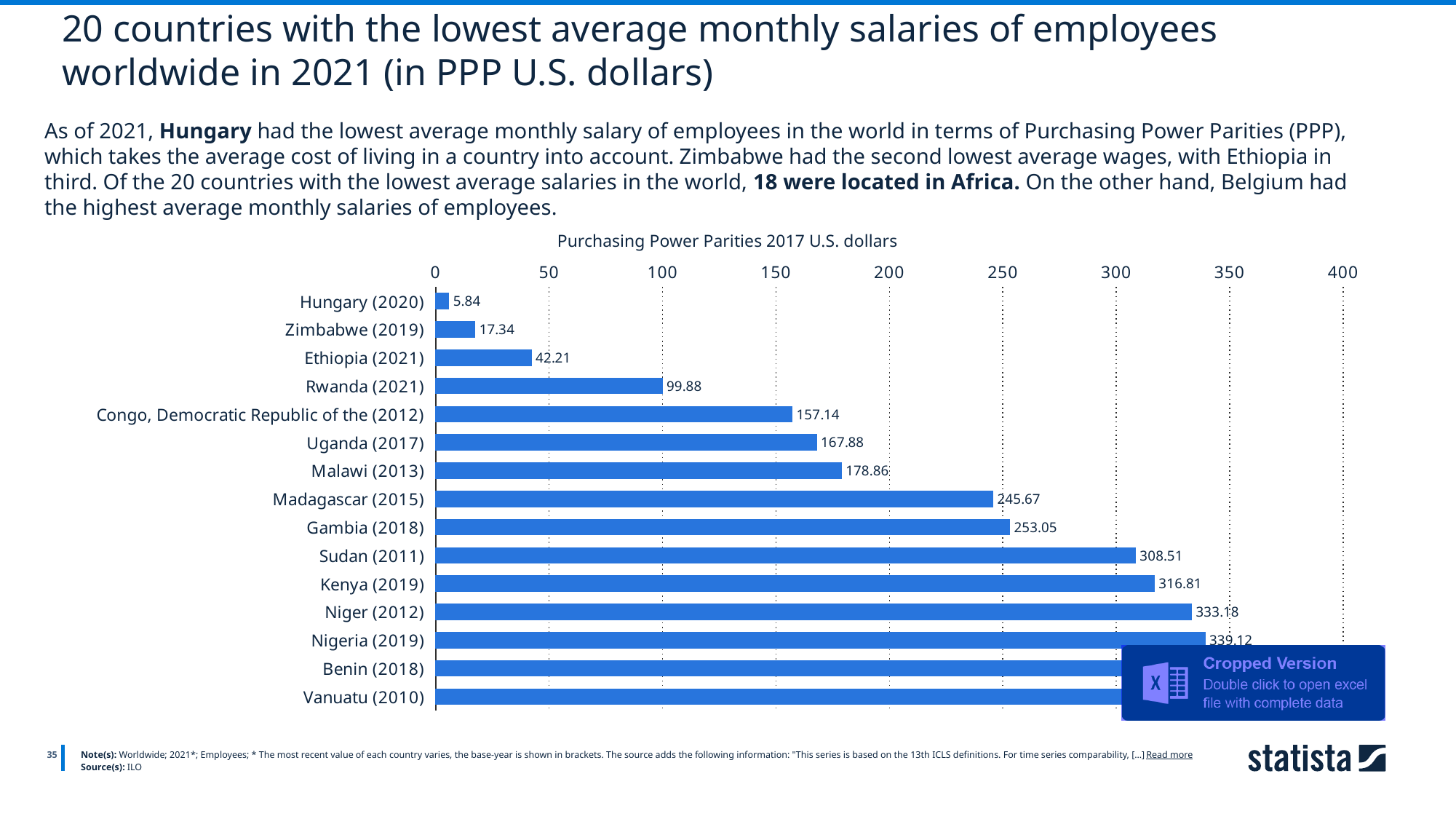
What is the difference between the values for Zimbabwe (2019) and Hungary (2020)? 11.50 What value is shown for Rwanda (2021)? 99.88 How many countries are listed in the chart? 15 What is the axis title shown above the chart? Purchasing Power Parities 2017 U.S. dollars Which has a larger value, Uganda (2017) or Malawi (2013)? Malawi (2013) What is the difference between the values for Kenya (2019) and Sudan (2011)? 8.30 What kind of chart is shown on the slide? bar chart Is the value for Sudan (2011) greater or less than 300? greater What value is shown for Niger (2012)? 333.18 What is the average monthly salary shown for Hungary (2020)? 5.84 What value is shown for Madagascar (2015)? 245.67 Which country has the lowest value in the chart? Hungary (2020)